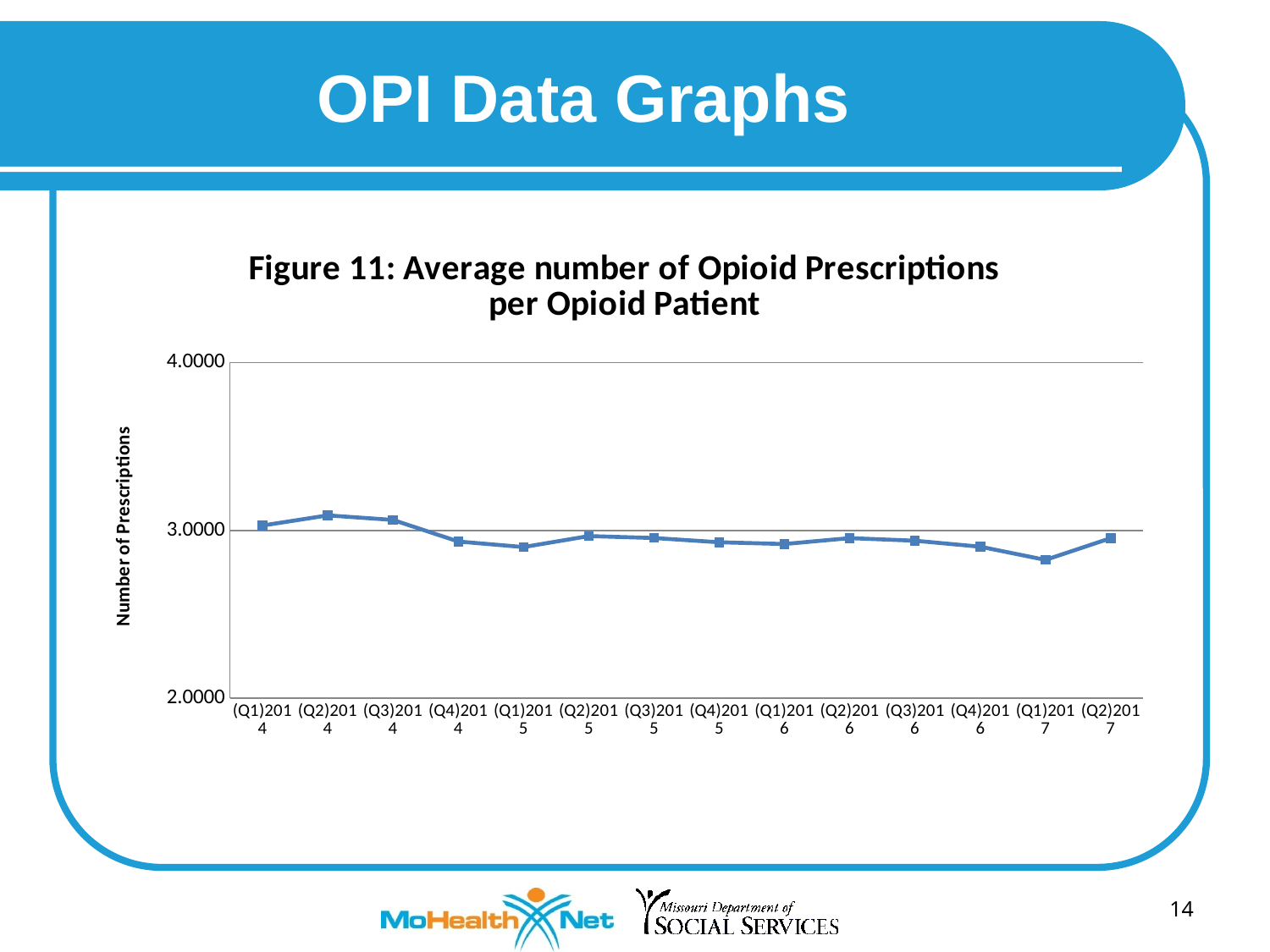
Is the value for (Q1)2017 greater or less than 3.0000? less Is the value for (Q3)2014 greater or less than 3.0000? greater What kind of chart is shown on the slide? line chart How many quarterly data points are plotted on the chart? 14 Which is larger, the value for (Q2)2014 or the value for (Q1)2017? (Q2)2014 Is the value for (Q2)2014 greater or less than 3.0000? greater Which quarter has the lowest average number of opioid prescriptions per opioid patient? (Q1)2017 Which quarter has the highest average number of opioid prescriptions per opioid patient? (Q2)2014 Do the values generally rise or fall from (Q1)2014 to (Q1)2017? fall What is the label on the vertical axis of the chart? Number of Prescriptions What is the title of the chart? Figure 11: Average number of Opioid Prescriptions per Opioid Patient